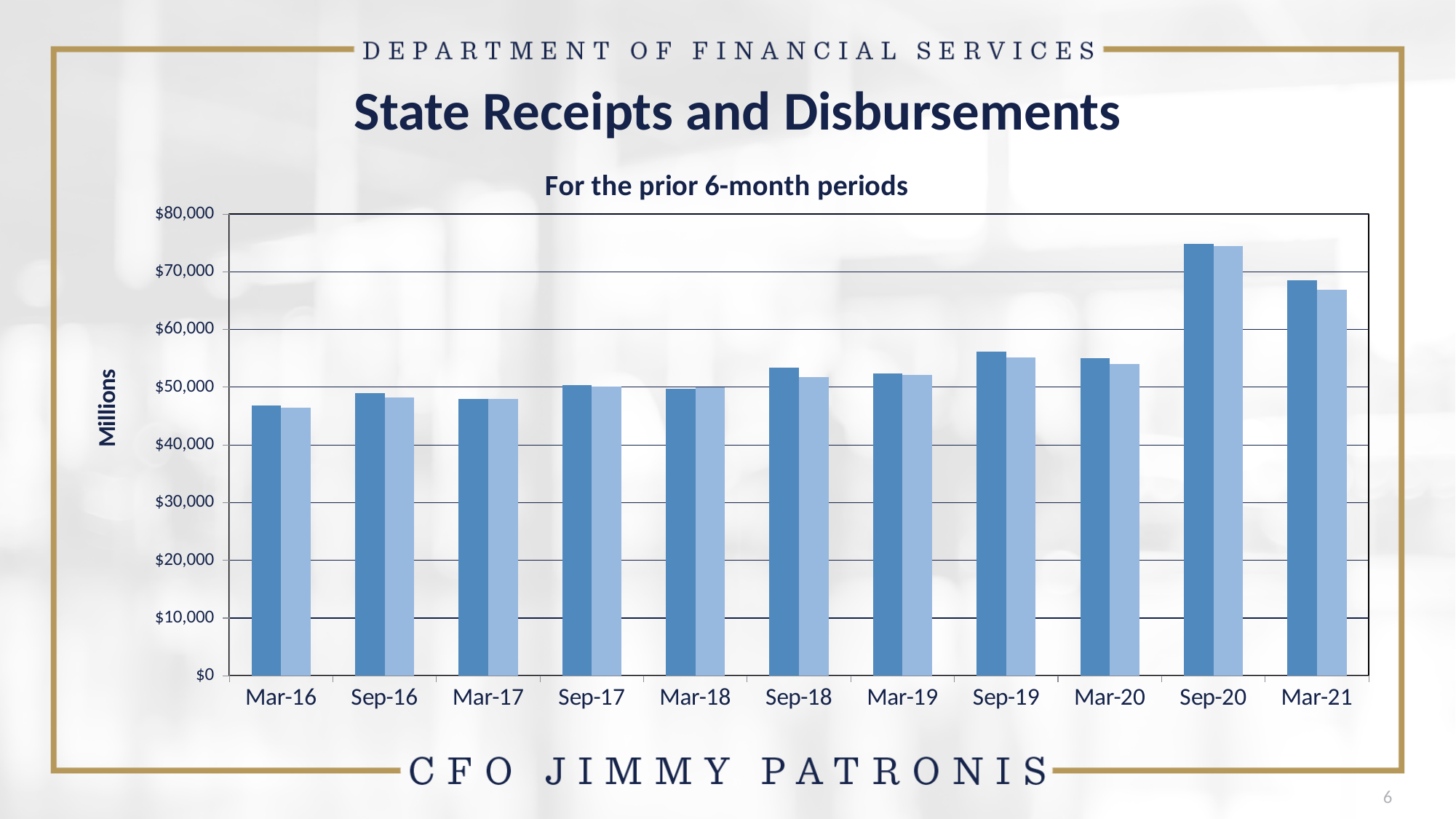
Is the value of the darker blue bar for Sep-20 greater or less than $70,000? greater Which period has the larger darker blue bar, Sep-20 or Mar-21? Sep-20 Is the value of the lighter blue bar for Mar-21 greater or less than $60,000? greater Is the value of the darker blue bar for Sep-19 greater or less than $50,000? greater How many bars are plotted for each period on the chart? 2 Which period has the larger darker blue bar, Mar-19 or Sep-19? Sep-19 What is the label on the vertical axis of the chart? Millions What kind of chart is shown on the slide? bar chart How many time periods are shown on the x axis of the chart? 11 Which period has the tallest bars on the chart? Sep-20 Which period has the shortest bars on the chart? Mar-16